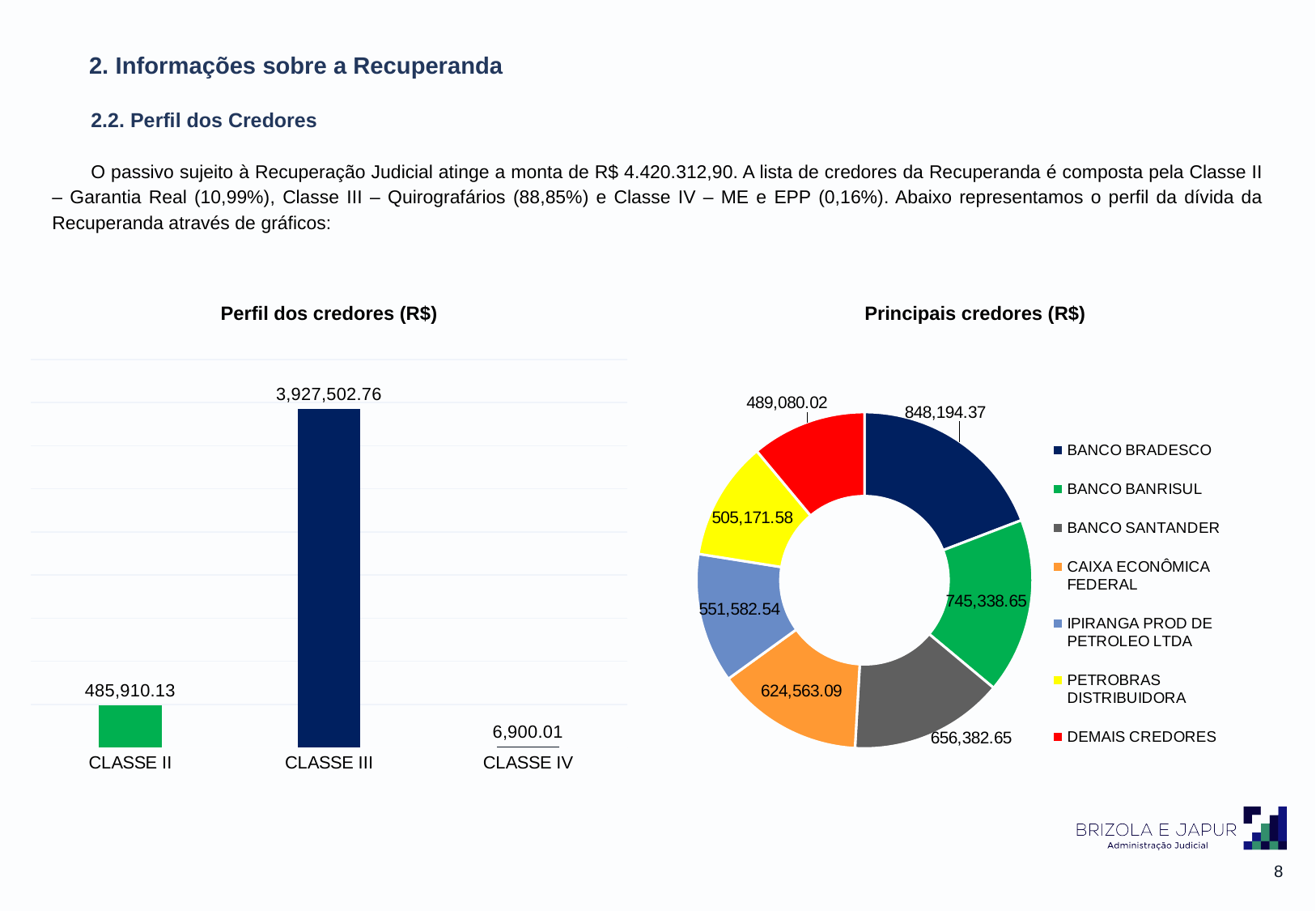
In the 'Perfil dos credores (R$)' chart, what is the value for CLASSE III? 3,927,502.76 What type of chart is 'Perfil dos credores (R$)'? Bar chart In the 'Perfil dos credores (R$)' chart, which class has the lowest value? CLASSE IV In the 'Perfil dos credores (R$)' chart, how many classes are shown? 3 In the 'Perfil dos credores (R$)' chart, what is the difference between CLASSE III and CLASSE II? 3,441,592.63 In the 'Principais credores (R$)' chart, which is larger: BANCO SANTANDER or CAIXA ECONÔMICA FEDERAL? BANCO SANTANDER In the 'Principais credores (R$)' chart, what is the difference between BANCO BRADESCO and DEMAIS CREDORES? 359,114.35 In the 'Principais credores (R$)' chart, what is the value for IPIRANGA PROD DE PETROLEO LTDA? 551,582.54 In the 'Principais credores (R$)' chart, which creditor has the largest value? BANCO BRADESCO In the 'Principais credores (R$)' chart, how many entries does the legend list? 7 In the 'Perfil dos credores (R$)' chart, what is the value for CLASSE IV? 6,900.01 In the 'Principais credores (R$)' chart, what is the value for BANCO BRADESCO? 848,194.37